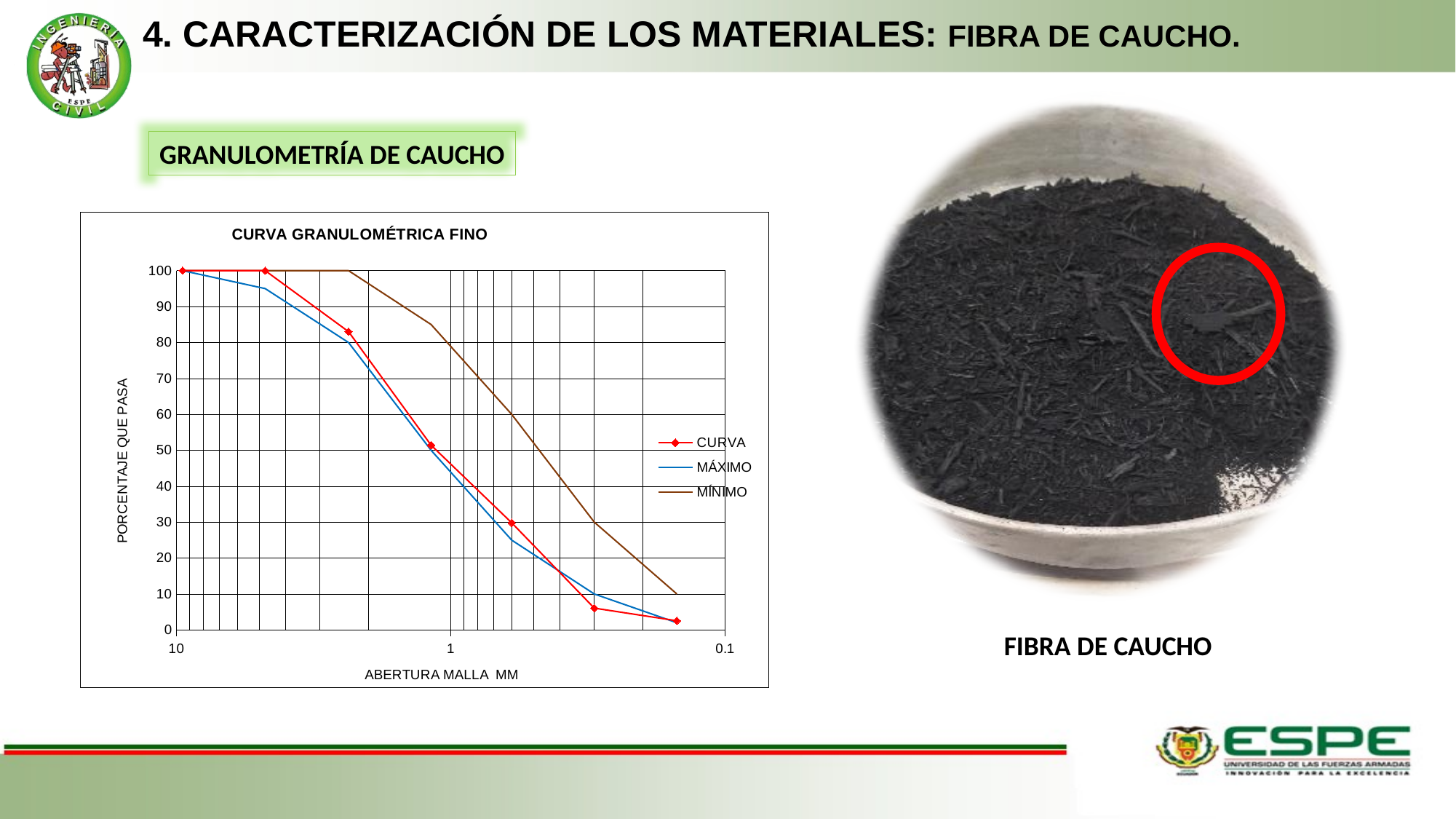
At an opening of 1 mm, which series has the larger value, MÍNIMO or CURVA? MÍNIMO What is the value of the MÍNIMO series at an opening of 10 mm? 100 What kind of chart is shown on the slide? line chart Which series has the highest value at an opening of 0.3 mm? MÍNIMO Is the value of the CURVA series at an opening of 1 mm greater or less than 40? greater How many series does the legend of the chart list? 3 Do the values of the CURVA series rise or fall moving from left to right along the x axis? fall What is the label of the vertical axis of the chart? PORCENTAJE QUE PASA What is the title of the chart? CURVA GRANULOMÉTRICA FINO Is the value of the MÁXIMO series at an opening of 1 mm greater or less than 50? less What is the value of the CURVA series at an opening of 10 mm? 100 Is the value of the MÍNIMO series at an opening of 1 mm greater or less than 60? greater